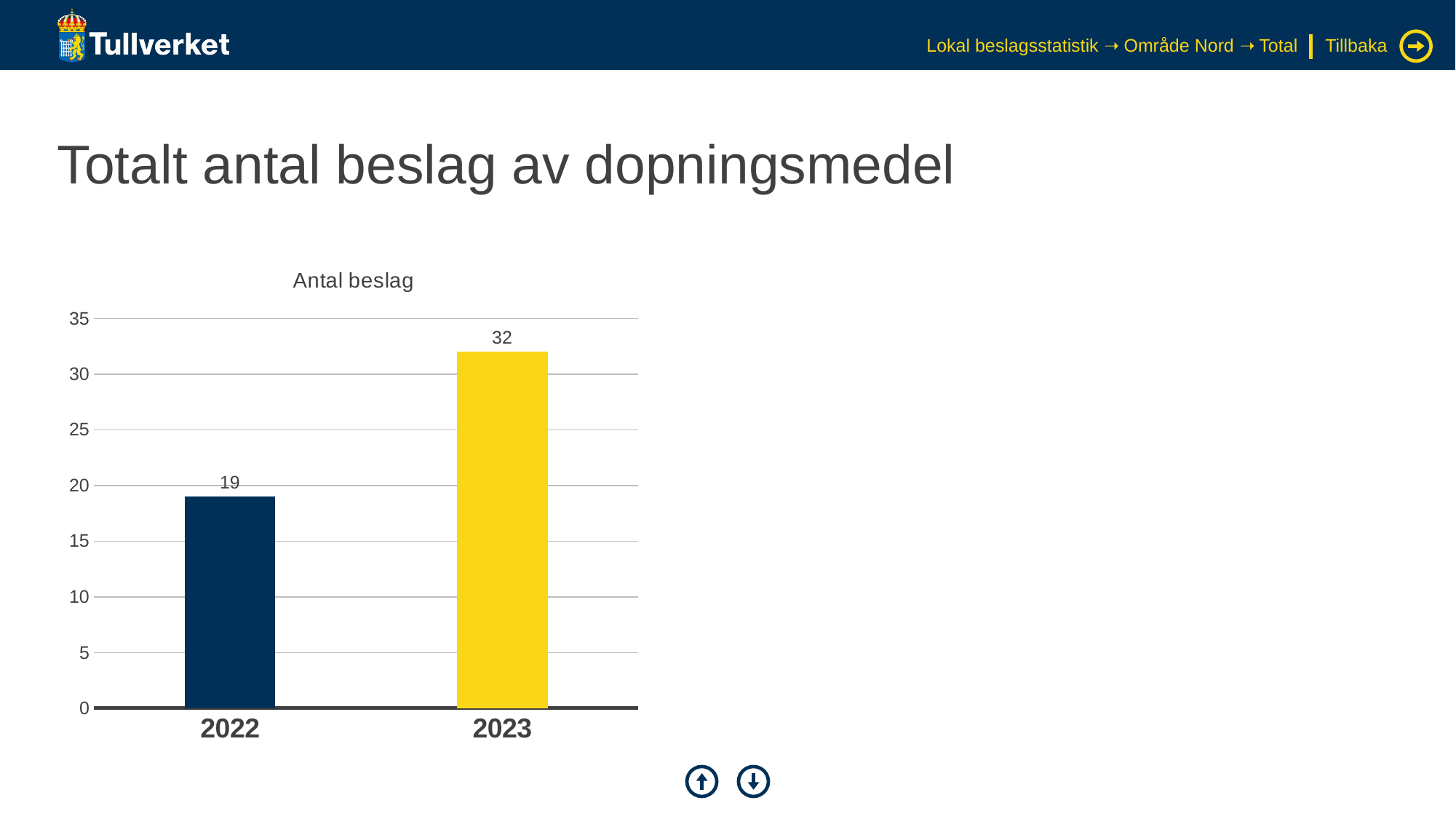
What is the value for 2022? 19 Is the value for 2023 greater or less than 30? greater Which year has the highest number of seizures? 2023 Do the values rise or fall from 2022 to 2023? rise What is the difference between the values for 2023 and 2022? 13 Is the value for 2022 greater or less than 20? less What is the title of the chart? Antal beslag Which is larger, the value for 2022 or the value for 2023? 2023 How many years are shown on the x axis? 2 Which year has the lowest number of seizures? 2022 What is the value for 2023? 32 What kind of chart is shown on the slide? bar chart